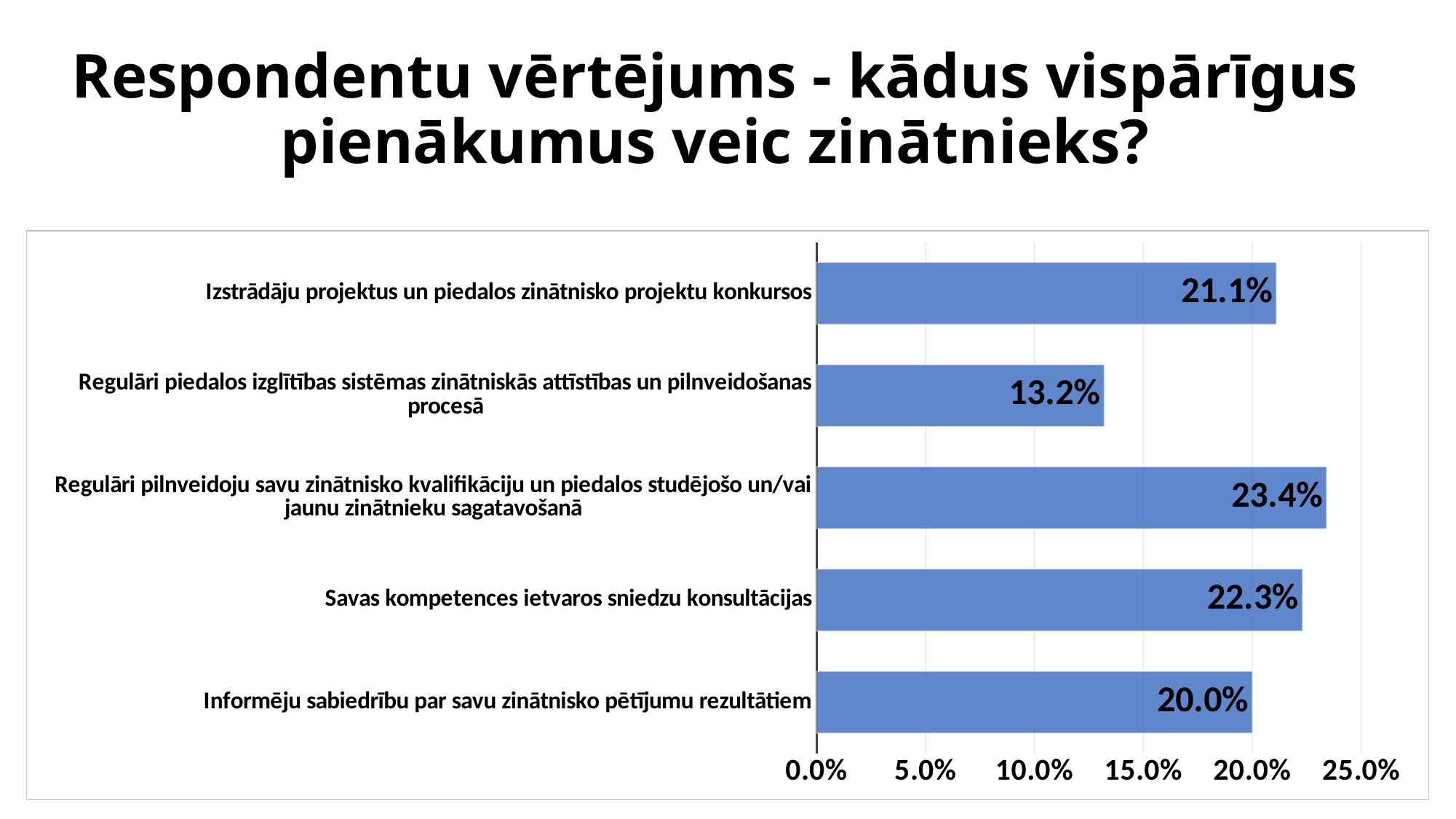
What is the value shown for "Informēju sabiedrību par savu zinātnisko pētījumu rezultātiem"? 20.0% Which category has the highest value in the chart? Regulāri pilnveidoju savu zinātnisko kvalifikāciju un piedalos studējošo un/vai jaunu zinātnieku sagatavošanā What is the difference between the values for "Savas kompetences ietvaros sniedzu konsultācijas" and "Izstrādāju projektus un piedalos zinātnisko projektu konkursos"? 1.2 percentage points What is the maximum value shown on the horizontal axis of the chart? 25.0% Which is larger: the value for "Savas kompetences ietvaros sniedzu konsultācijas" or for "Informēju sabiedrību par savu zinātnisko pētījumu rezultātiem"? Savas kompetences ietvaros sniedzu konsultācijas What type of chart is shown on the slide? Bar chart How many categories are shown in the chart? 5 Which category has the lowest value in the chart? Regulāri piedalos izglītības sistēmas zinātniskās attīstības un pilnveidošanas procesā What percentage of respondents selected "Izstrādāju projektus un piedalos zinātnisko projektu konkursos"? 21.1% What is the value shown for "Savas kompetences ietvaros sniedzu konsultācijas"? 22.3% Is the value for "Regulāri piedalos izglītības sistēmas zinātniskās attīstības un pilnveidošanas procesā" greater or less than 15.0%? less What is the difference between the highest value (23.4%) and the lowest value (13.2%) in the chart? 10.2 percentage points